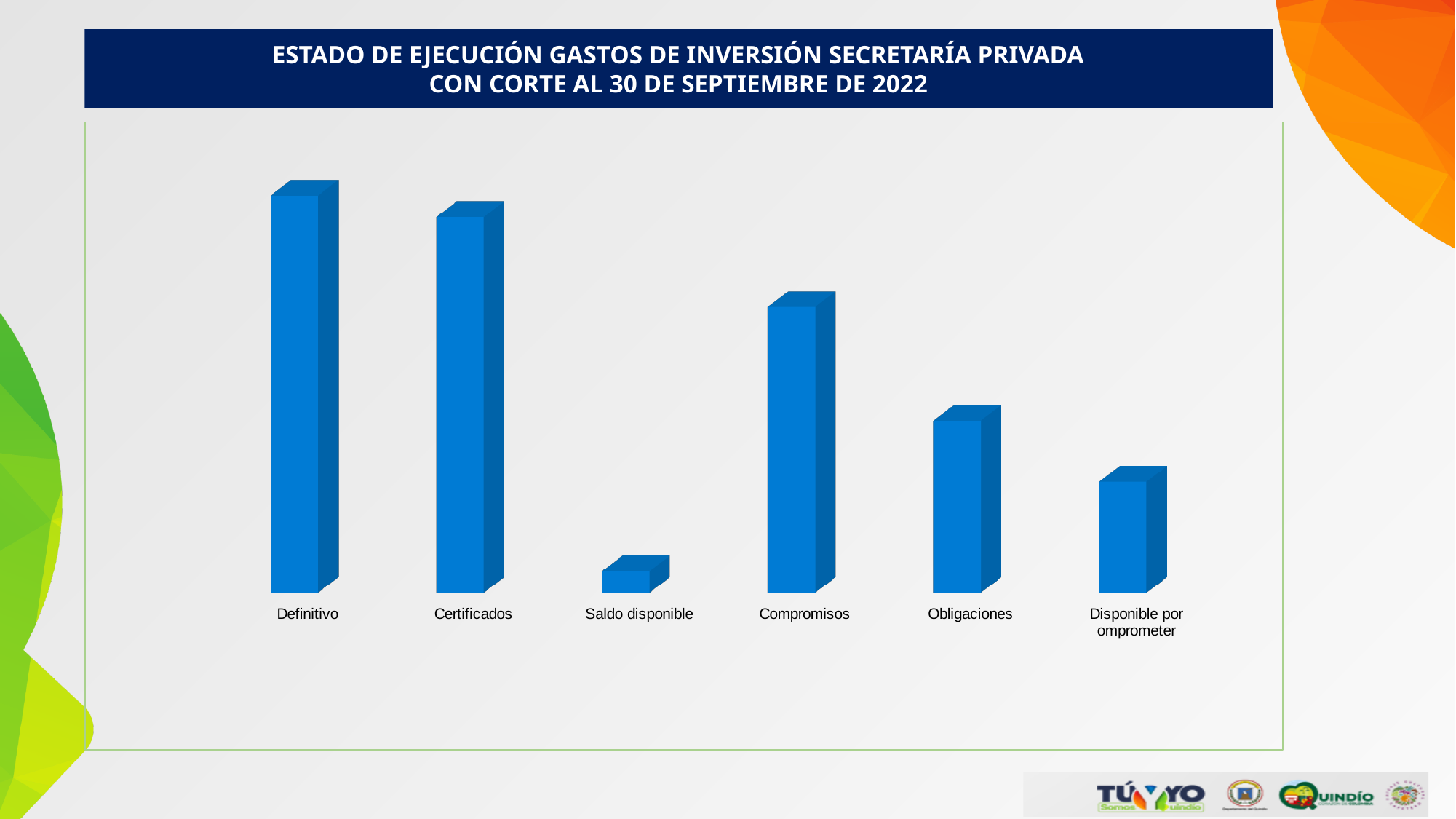
What colour are the bars in the chart? blue Which is larger, the bar for Compromisos or the bar for Obligaciones? Compromisos Which is larger, the bar for Certificados or the bar for Saldo disponible? Certificados Which is larger, the bar for Compromisos or the bar for Disponible por omprometer? Compromisos How many categories are plotted in the chart? 6 Which category has the lowest bar? Saldo disponible What kind of chart is shown on the slide? bar chart What is the title shown above the chart? ESTADO DE EJECUCIÓN GASTOS DE INVERSIÓN SECRETARÍA PRIVADA CON CORTE AL 30 DE SEPTIEMBRE DE 2022 Which category has the highest bar? Definitivo